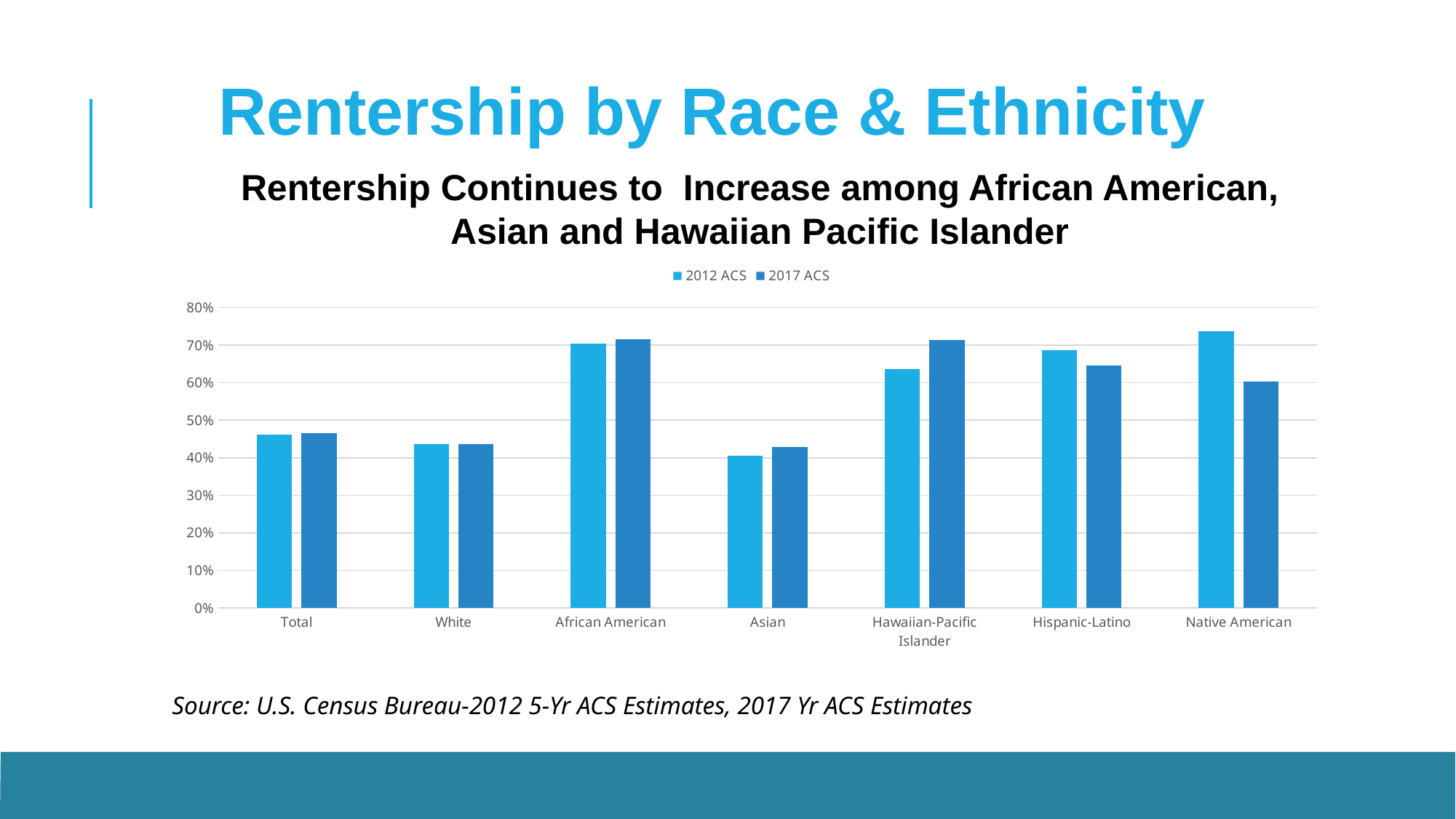
Which category has the highest 2012 ACS rentership rate? Native American For Hawaiian-Pacific Islander, which is larger: the 2012 ACS value or the 2017 ACS value? 2017 ACS What are the two series named in the legend? 2012 ACS and 2017 ACS For Hispanic-Latino, which is larger: the 2012 ACS value or the 2017 ACS value? 2012 ACS Which category has the lowest 2012 ACS rentership rate? Asian Is the 2012 ACS value for Native American greater or less than 70%? greater Is the 2012 ACS value for Asian greater or less than 50%? less How many series does the legend list? 2 For Native American, which is larger: the 2012 ACS value or the 2017 ACS value? 2012 ACS How many race/ethnicity categories are shown on the x axis? 7 Is the 2017 ACS value for Native American greater or less than 70%? less What kind of chart is shown on the slide? bar chart